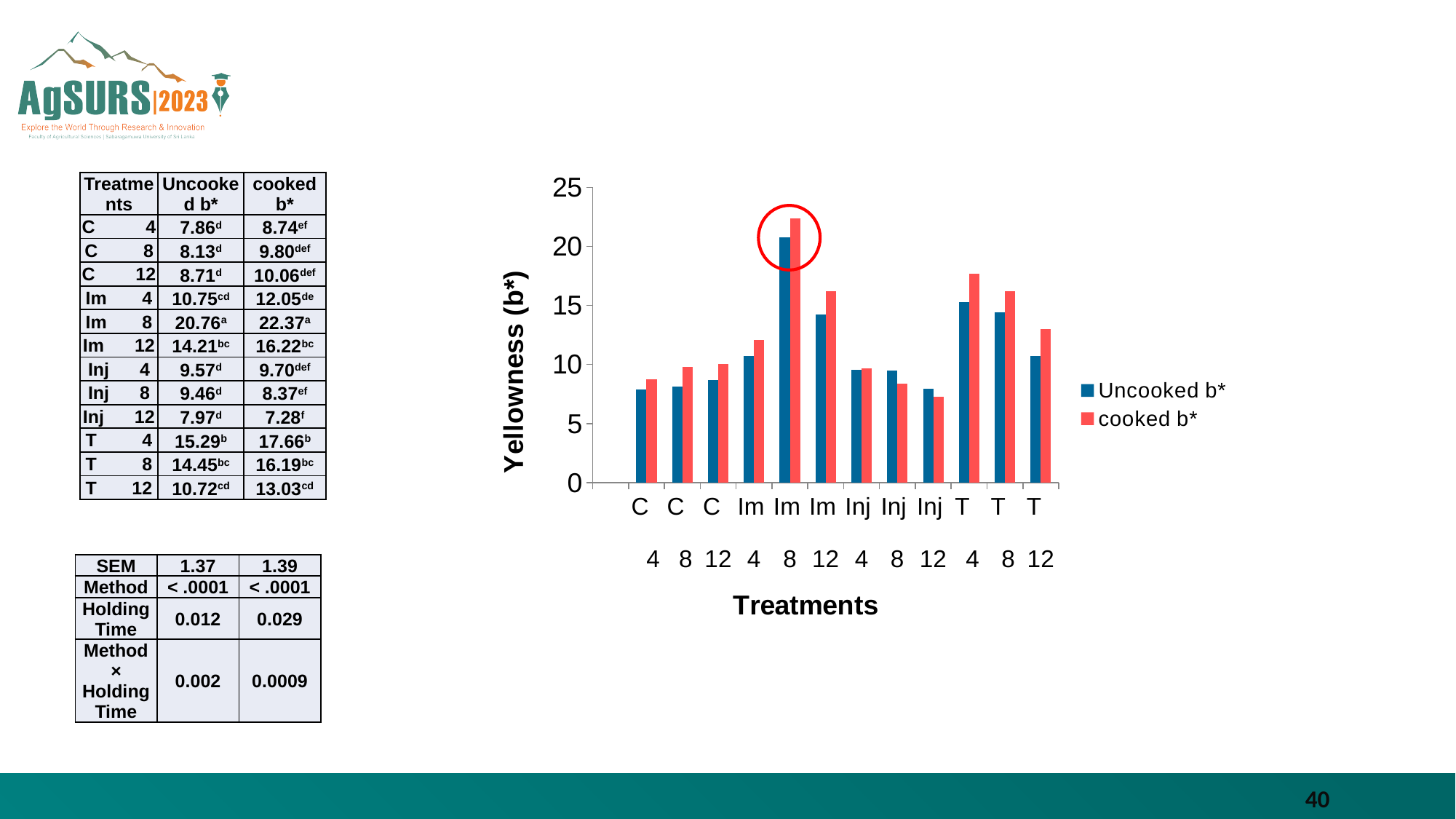
Which treatment has the highest Uncooked b* bar in the chart? Im 8 How many treatment categories are plotted along the x axis of the chart? 12 For treatment T 4, which series has the larger bar, Uncooked b* or cooked b*? cooked b* What kind of chart is shown on the slide? bar chart Is the cooked b* value for Im 8 greater or less than 20? greater What is the title of the y axis of the chart? Yellowness (b*) Which treatment has the highest cooked b* bar in the chart? Im 8 How many series does the chart legend list? 2 Is the cooked b* value for T 4 greater or less than 15? greater Is the cooked b* value for Inj 12 greater or less than 10? less Which has the larger cooked b* bar, Im 8 or T 4? Im 8